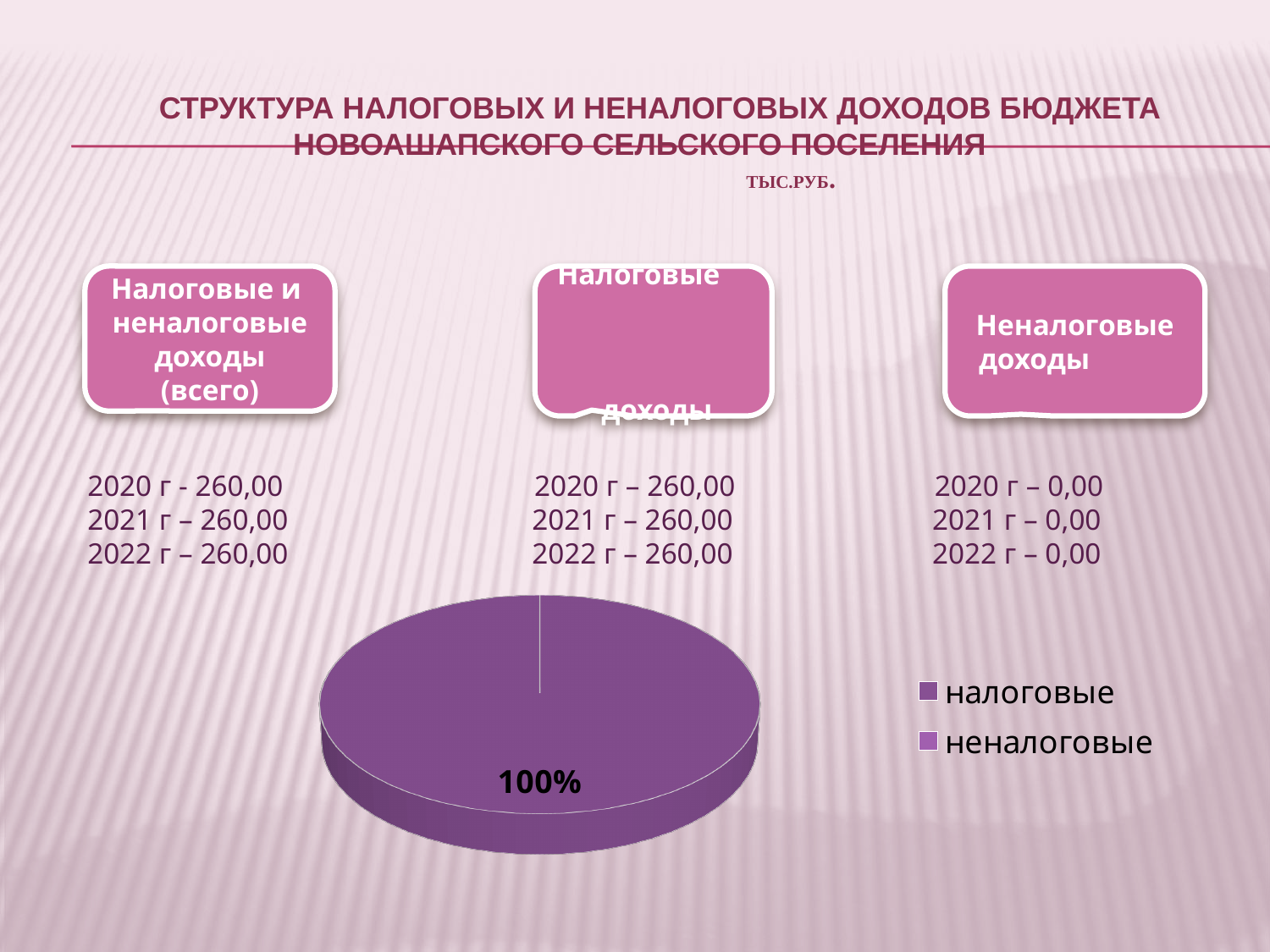
Which is larger in the pie chart, налоговые or неналоговые? налоговые How many entries does the legend of the pie chart list? 2 What kind of chart is shown on the slide? pie chart What share of the pie does the налоговые slice take? 100% What percentage label is printed on the pie chart? 100% What colour is the налоговые slice in the pie chart? purple What are the two legend entries of the pie chart? налоговые, неналоговые How many slices are visible in the pie chart? 1 Which category has the largest share in the pie chart? налоговые Which category has the smallest share in the pie chart? неналоговые